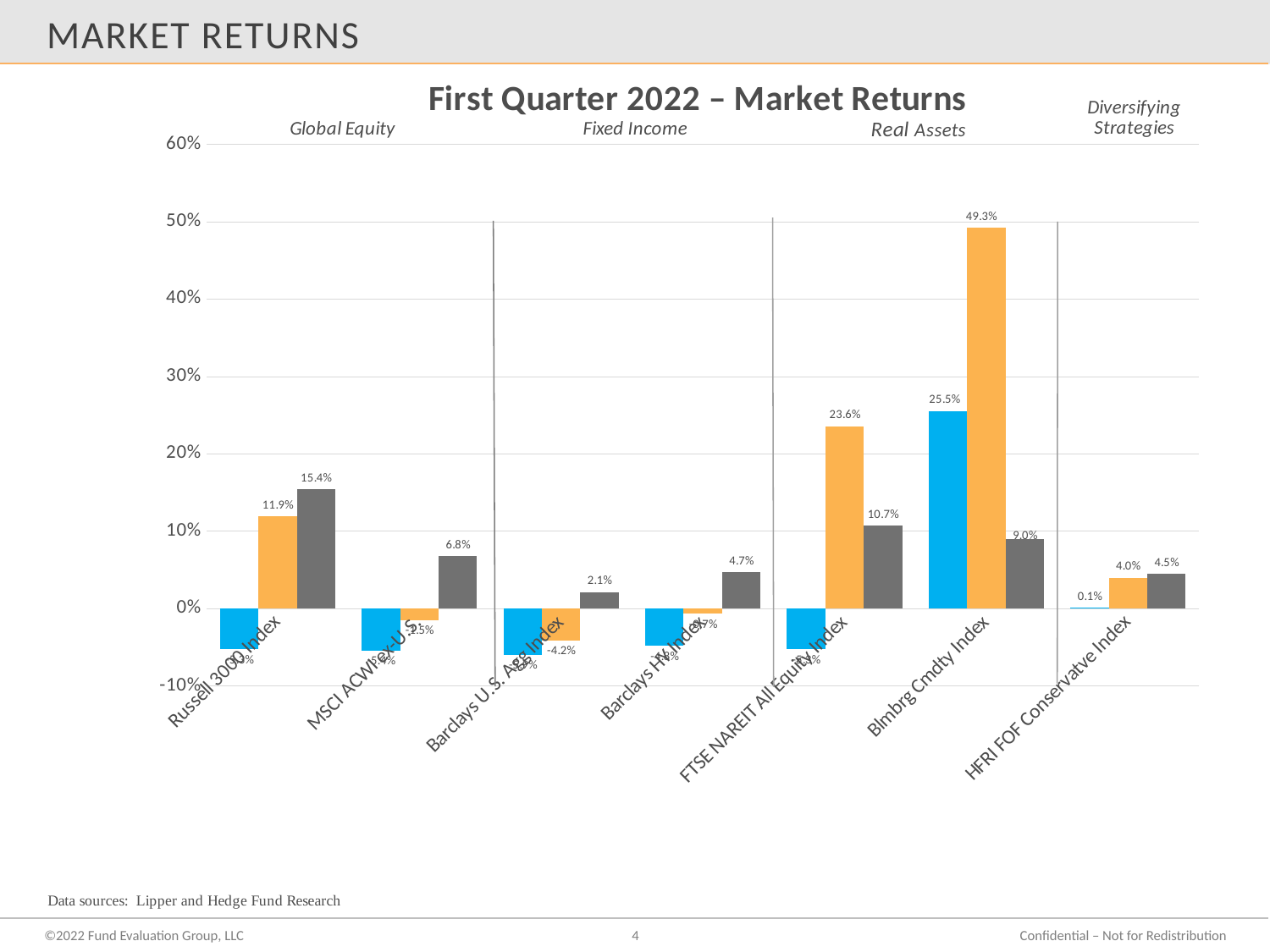
What is the value of the blue bar for the HFRI FOF Conservative Index? 0.1% Which index has the lowest orange bar? Barclays U.S. Agg Index What is the value of the orange bar for the FTSE NAREIT All Equity Index? 23.6% Which index has the highest orange bar? Blmbrg Cmdty Index How many index categories are shown along the x axis? 7 What is the value of the orange bar for the Blmbrg Cmdty Index? 49.3% Which is larger: the grey bar for the Russell 3000 Index or the grey bar for the FTSE NAREIT All Equity Index? Russell 3000 Index What is the value of the grey bar for the Russell 3000 Index? 15.4% What is the difference between the orange bar and the blue bar for the Blmbrg Cmdty Index? 23.8 percentage points What type of chart is shown on the slide? Bar chart What is the title of the chart? First Quarter 2022 – Market Returns Is the blue bar for the Russell 3000 Index greater or less than 0%? less